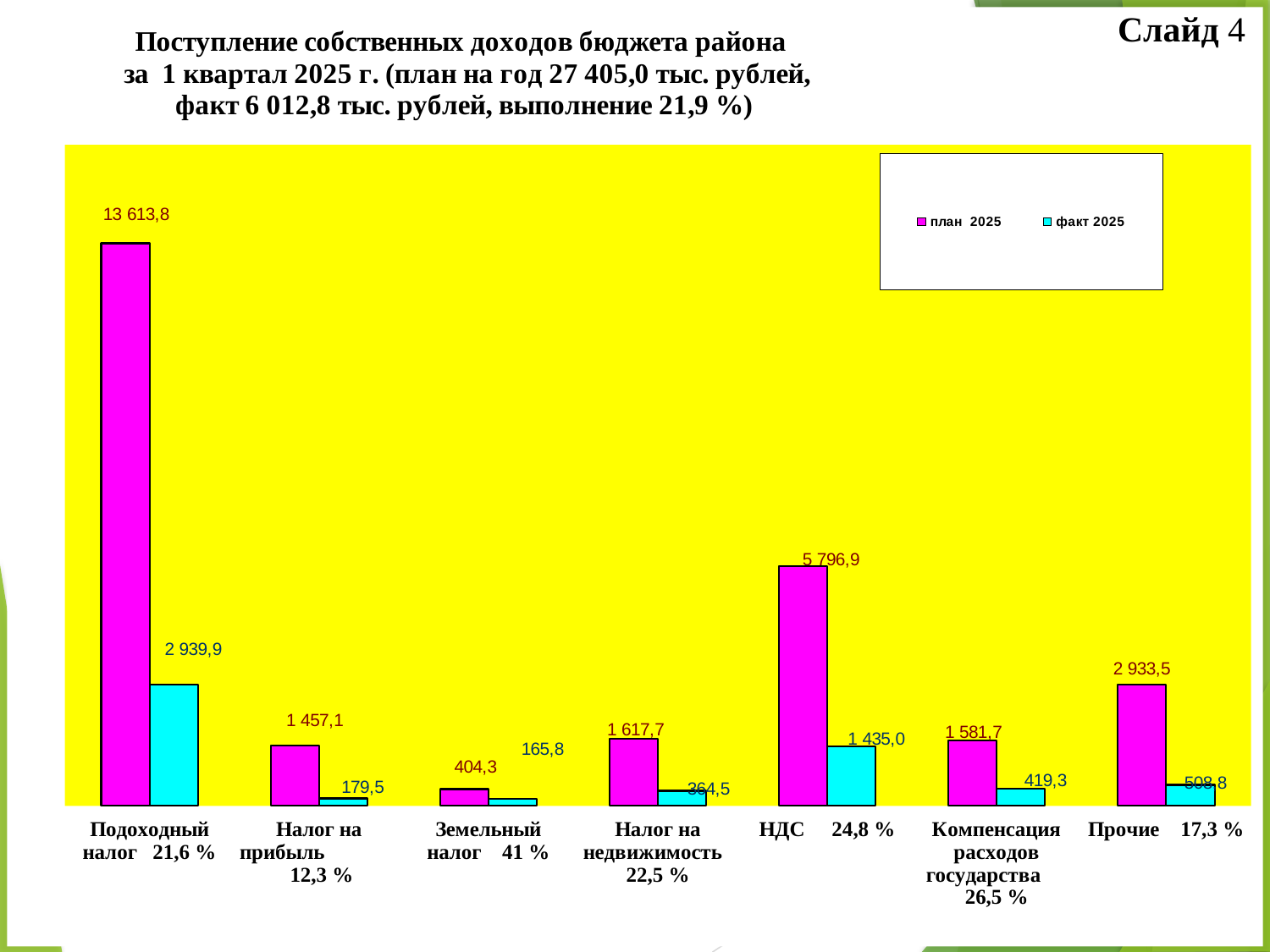
Which category has the highest план 2025 value? Подоходный налог What is the факт 2025 value for Земельный налог? 165,8 Which category has the lowest план 2025 value? Земельный налог What is the план 2025 value for Компенсация расходов государства? 1 581,7 What is the difference between the план 2025 and факт 2025 values for НДС? 4 361,9 What is the план 2025 value for Подоходный налог? 13 613,8 What is the факт 2025 value for НДС? 1 435,0 How many categories are shown on the x axis of the chart? 7 How many series does the legend list? 2 What kind of chart is shown on the slide? Bar chart What is the difference between the план 2025 and факт 2025 values for Земельный налог? 238,5 Which is larger: the план 2025 value for НДС or the план 2025 value for Прочие? НДС